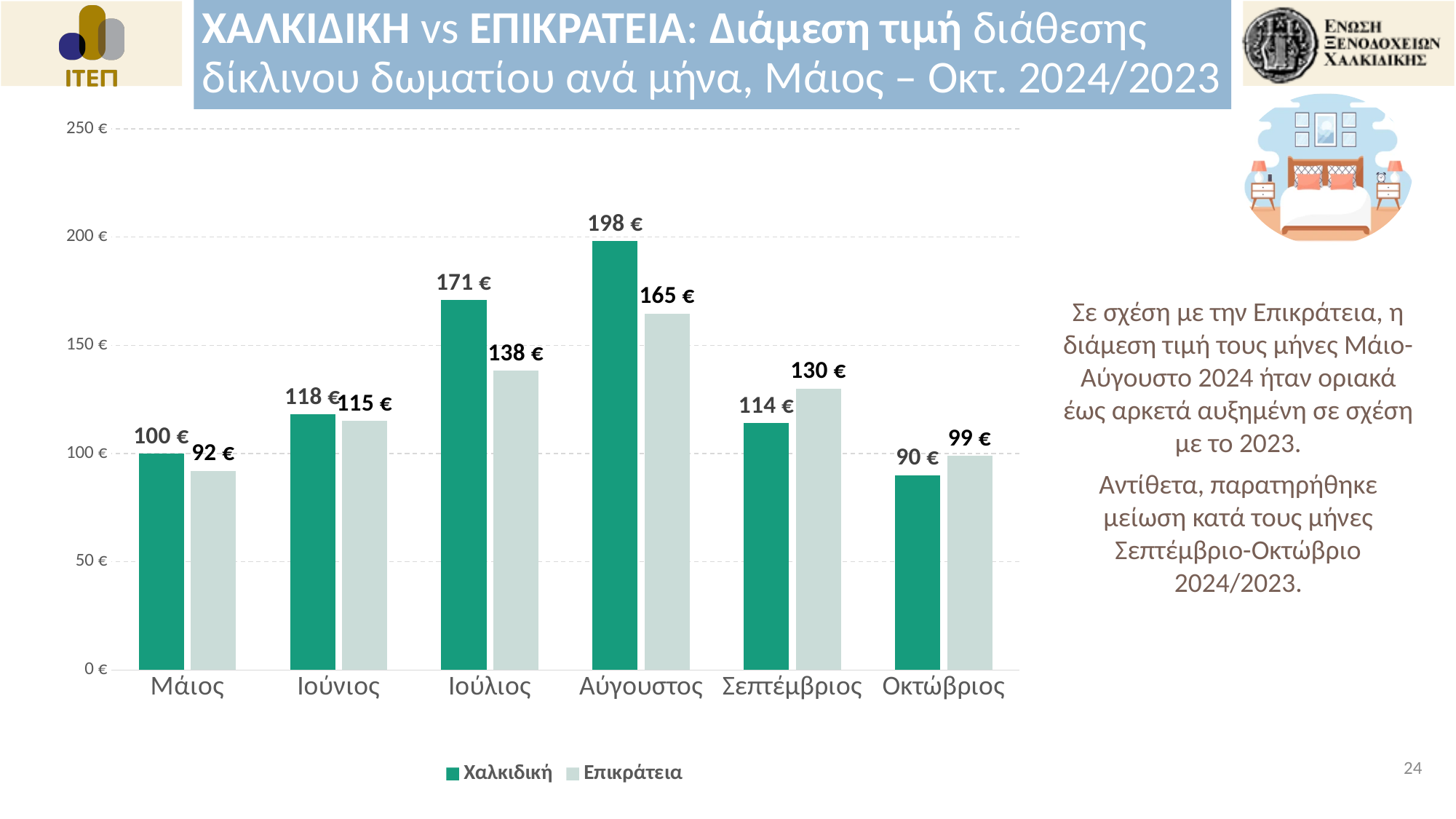
Is the value for Χαλκιδική in Ιούλιος greater or less than 150 €? greater What is the difference between Χαλκιδική and Επικράτεια in Σεπτέμβριος? 16 € What is the value for Χαλκιδική in Αύγουστος? 198 € How many months are shown on the x axis? 6 Which month has the highest value for Επικράτεια? Αύγουστος What is the difference between Χαλκιδική and Επικράτεια in Αύγουστος? 33 € Which month has the lowest value for Χαλκιδική? Οκτώβριος What kind of chart is shown on the slide? Bar chart What is the value for Επικράτεια in Ιούλιος? 138 € How many series does the legend list? 2 Which is larger in Οκτώβριος, Χαλκιδική or Επικράτεια? Επικράτεια What is the value for Χαλκιδική in Οκτώβριος? 90 €